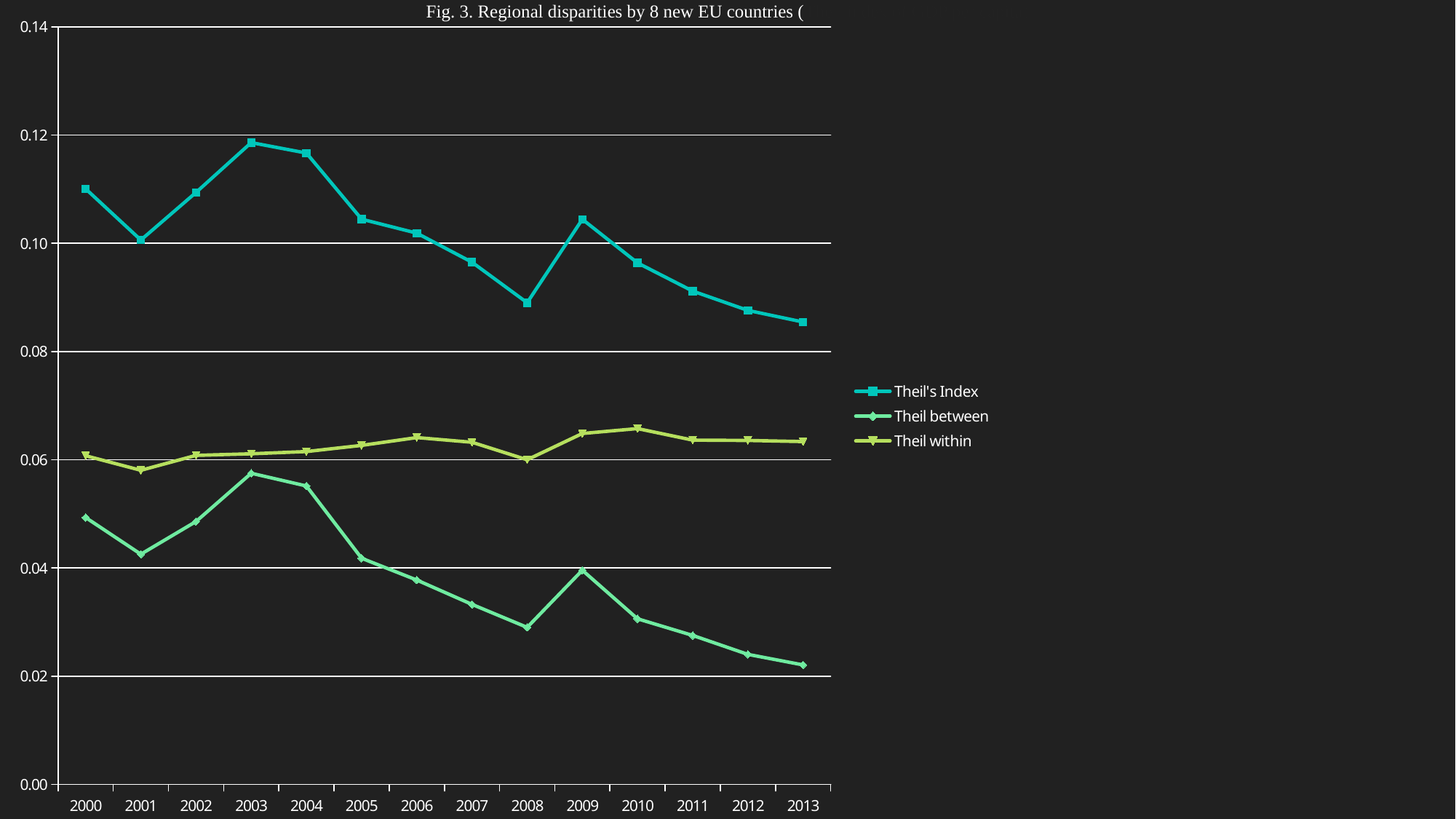
In which year is the Theil within series at its lowest? 2001 In which year does the Theil's Index series reach its highest value? 2003 Is the value of Theil between in 2008 greater or less than 0.04? less In which year is the Theil between series at its lowest? 2013 Is the value of Theil's Index in 2013 greater or less than 0.10? less How many series does the legend list? 3 Is the value of Theil within in 2006 greater or less than 0.06? greater Does the Theil's Index series rise or fall from 2009 to 2013? fall Which is larger for Theil between: the value in 2009 or the value in 2010? 2009 In which year does the Theil's Index series reach its lowest value? 2013 What kind of chart is shown on the slide? line chart How many years are plotted along the x axis? 14